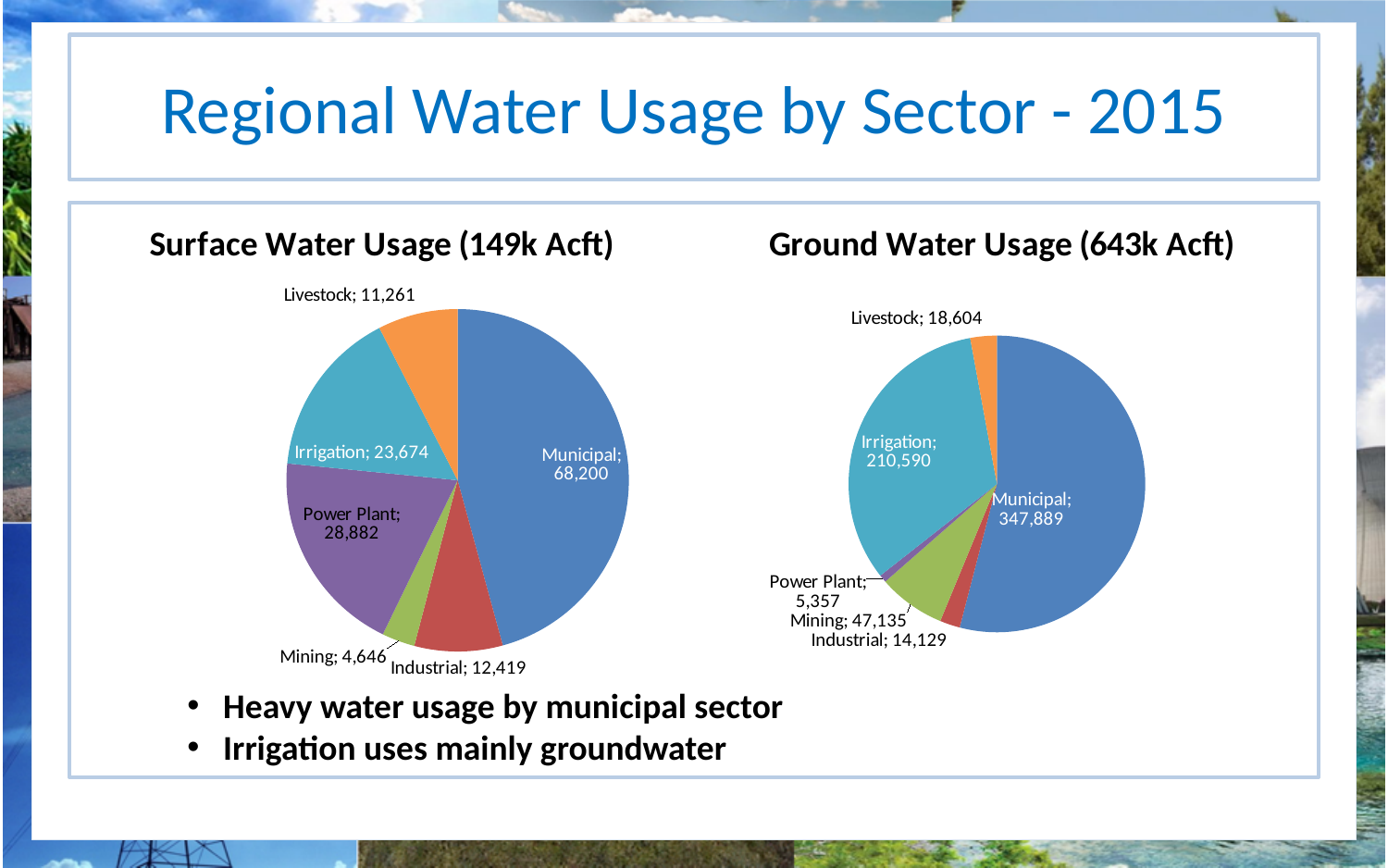
On the Ground Water Usage chart, what is the difference between Municipal and Irrigation? 137,299 On the Surface Water Usage chart, what is the difference between Power Plant and Irrigation? 5,208 What type of chart is the Ground Water Usage chart? Pie chart On the Surface Water Usage chart, what is the value for Municipal? 68,200 On the Surface Water Usage chart, which sector has the largest slice? Municipal On the Ground Water Usage chart, what is the value for Mining? 47,135 On the Surface Water Usage chart, which sector has the smallest slice? Mining How many sectors are shown on the Surface Water Usage chart? 6 On the Ground Water Usage chart, what is the value for Irrigation? 210,590 On the Surface Water Usage chart, what is the value for Power Plant? 28,882 On the Ground Water Usage chart, which sector has the smallest slice? Power Plant On the Ground Water Usage chart, which is larger, Mining or Livestock? Mining